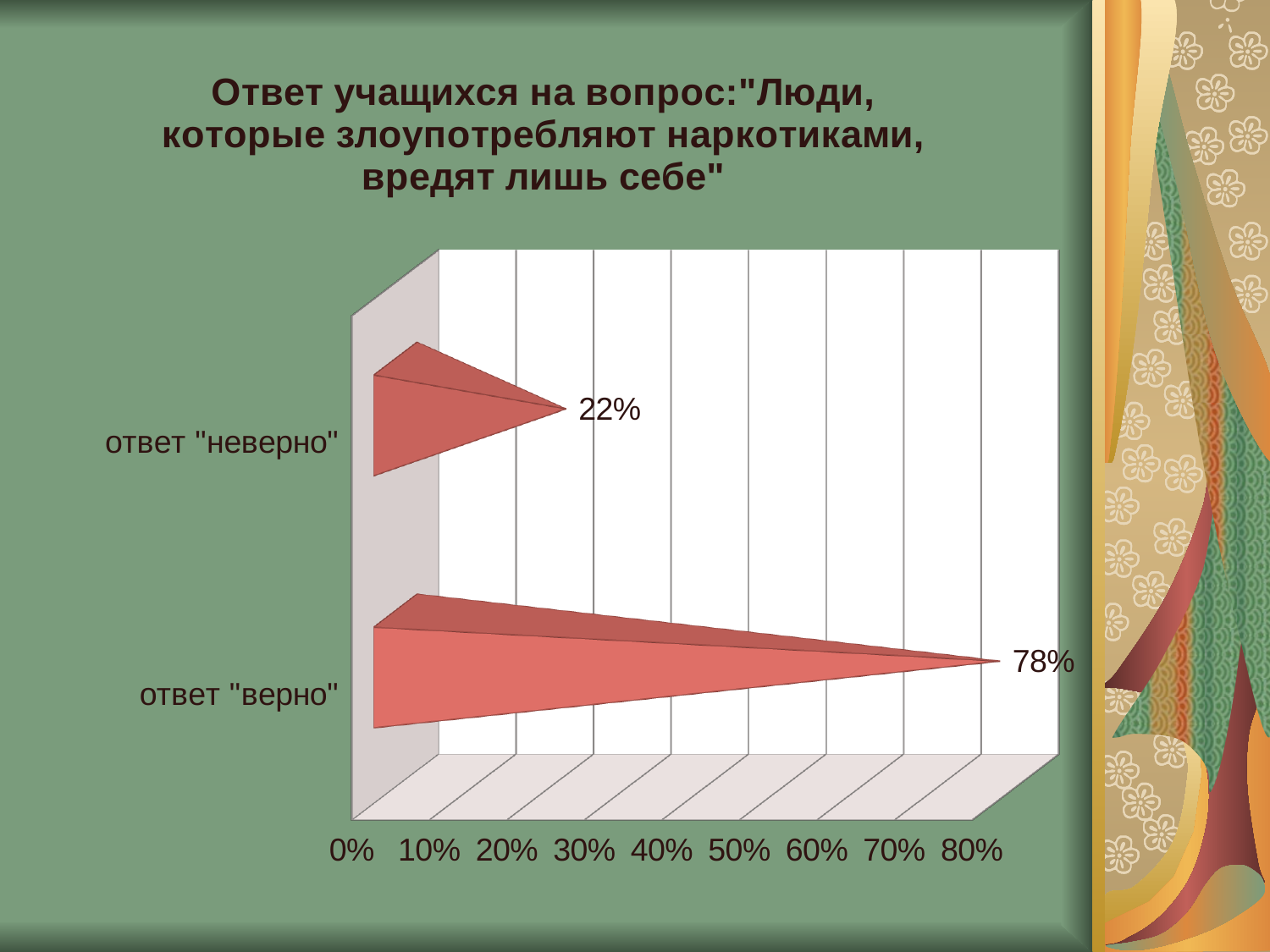
What kind of chart is shown on the slide? bar chart Which category has the lowest value? ответ "неверно" How many categories are shown in the chart? 2 What is the highest value shown on the horizontal axis? 80% What is the value for ответ "верно"? 78% What is the value for ответ "неверно"? 22% What is the title of the chart? Ответ учащихся на вопрос:"Люди, которые злоупотребляют наркотиками, вредят лишь себе" Is the value for ответ "неверно" greater or less than 30%? less Which is larger, the value for ответ "верно" or ответ "неверно"? ответ "верно" Which category has the highest value? ответ "верно" Is the value for ответ "верно" greater or less than 70%? greater What is the difference between the values for ответ "верно" and ответ "неверно"? 56%